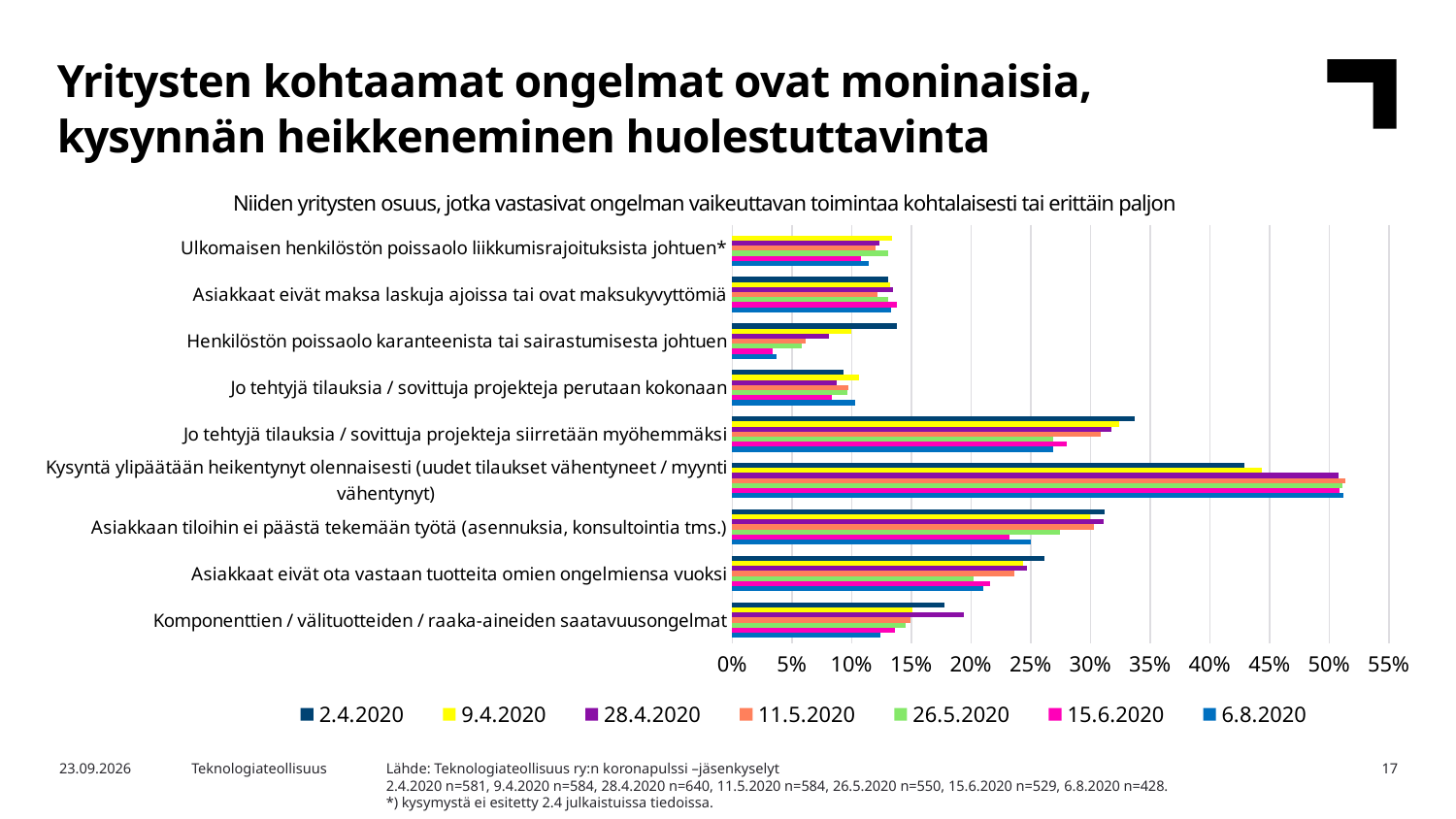
How many categories (problems) are listed on the chart's vertical axis? 9 Is the 6.8.2020 value for 'Asiakkaat eivät ota vastaan tuotteita omien ongelmiensa vuoksi' greater or less than 25%? less How many series does the chart legend list? 7 Which category has the highest values across the series? Kysyntä ylipäätään heikentynyt olennaisesti (uudet tilaukset vähentyneet / myynti vähentynyt) For the 2.4.2020 series, which is larger: 'Kysyntä ylipäätään heikentynyt olennaisesti' or 'Jo tehtyjä tilauksia / sovittuja projekteja siirretään myöhemmäksi'? Kysyntä ylipäätään heikentynyt olennaisesti What kind of chart is shown on the slide? Bar chart Is the 6.8.2020 value for 'Henkilöstön poissaolo karanteenista tai sairastumisesta johtuen' greater or less than 5%? less Is the 2.4.2020 value for 'Komponenttien / välituotteiden / raaka-aineiden saatavuusongelmat' greater or less than 15%? greater What is the subtitle printed above the chart? Niiden yritysten osuus, jotka vastasivat ongelman vaikeuttavan toimintaa kohtalaisesti tai erittäin paljon Which date is the last series listed in the legend? 6.8.2020